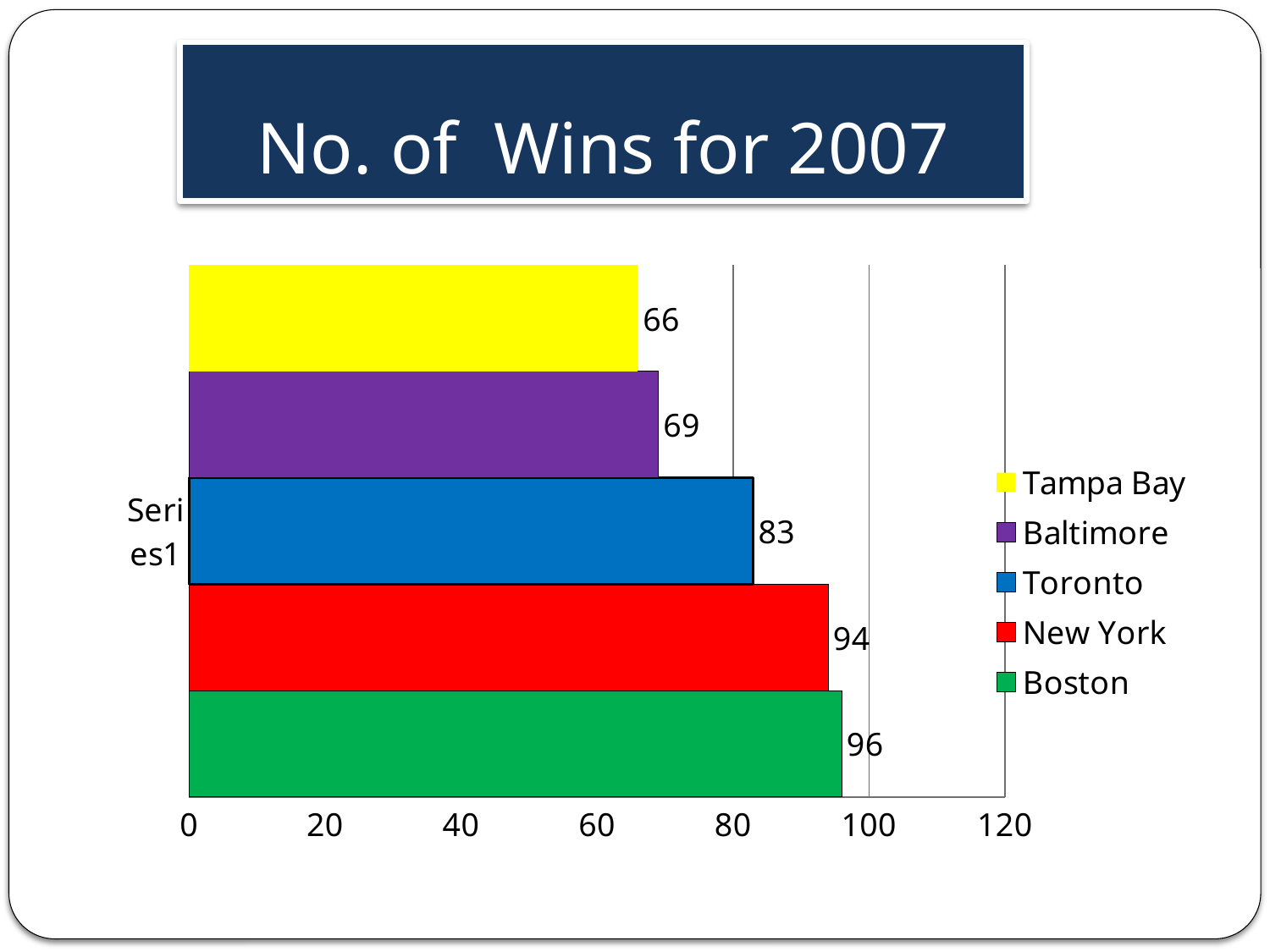
What is the title of the chart? No. of Wins for 2007 What is the difference between New York's and Baltimore's wins? 25 What is the value shown for Tampa Bay? 66 Which team has the lowest number of wins? Tampa Bay Which team has the highest number of wins? Boston What is the value shown for Toronto? 83 How many wins does Boston have in the chart? 96 What kind of chart is shown on the slide? bar chart Which has more wins, Toronto or Baltimore? Toronto Is the value for New York greater or less than 100? less How many teams are shown in the chart? 5 What colour is the bar for Baltimore? purple